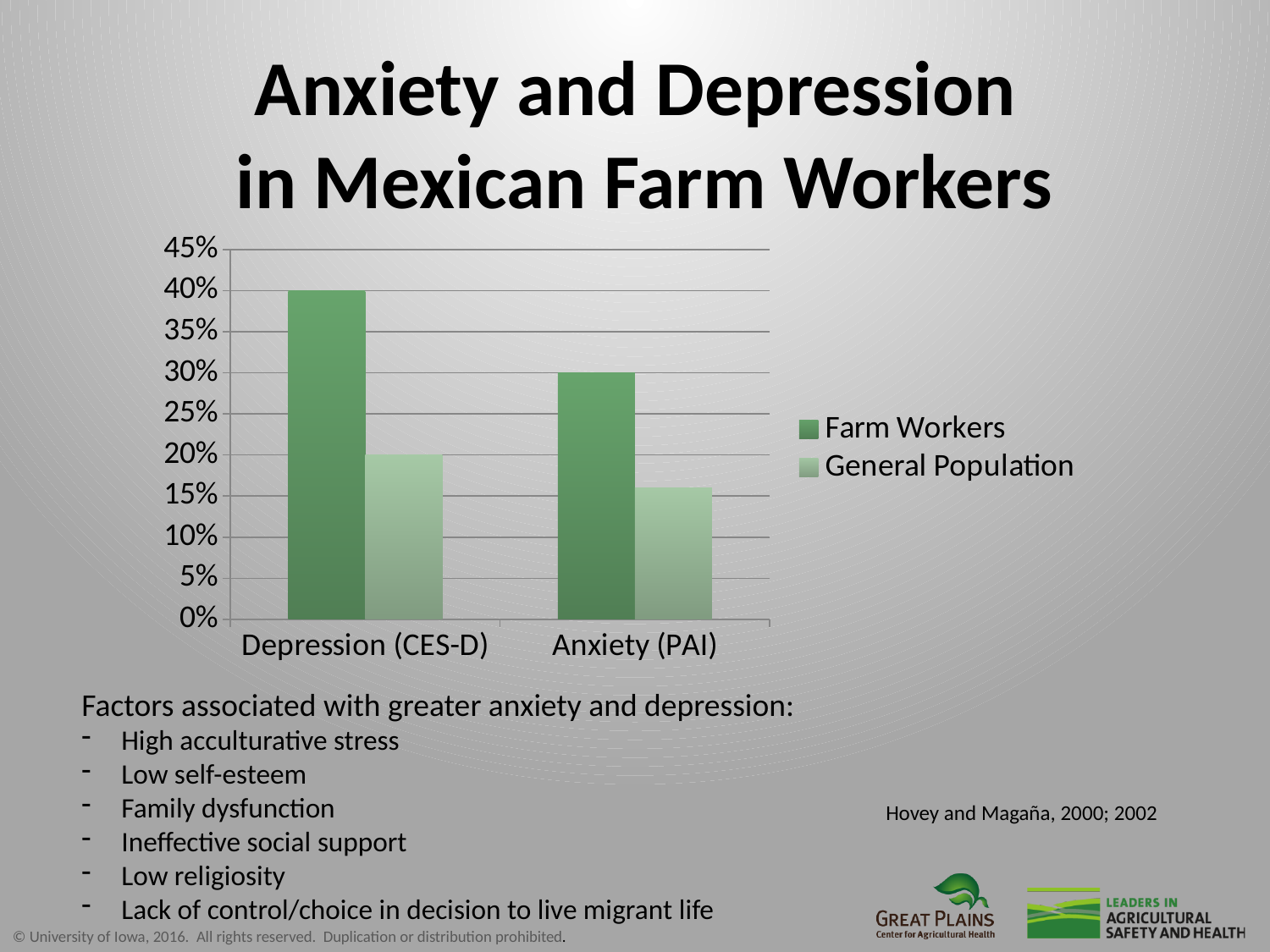
Do the Farm Workers values rise or fall from Depression (CES-D) to Anxiety (PAI)? fall Which bar in the chart is the highest? Farm Workers, Depression (CES-D) What is the value for Farm Workers in the Anxiety (PAI) category? 30% What is the value for General Population in the Depression (CES-D) category? 20% How many categories are shown on the x axis of the chart? 2 How many series does the chart legend list? 2 Which bar in the chart is the lowest? General Population, Anxiety (PAI) What is the difference between the Farm Workers and General Population values for Depression (CES-D)? 20% What kind of chart is shown on the slide? bar chart What is the value for Farm Workers in the Depression (CES-D) category? 40% Is the value for General Population in the Anxiety (PAI) category greater or less than 20%? less Which is larger for Anxiety (PAI): the Farm Workers value or the General Population value? Farm Workers